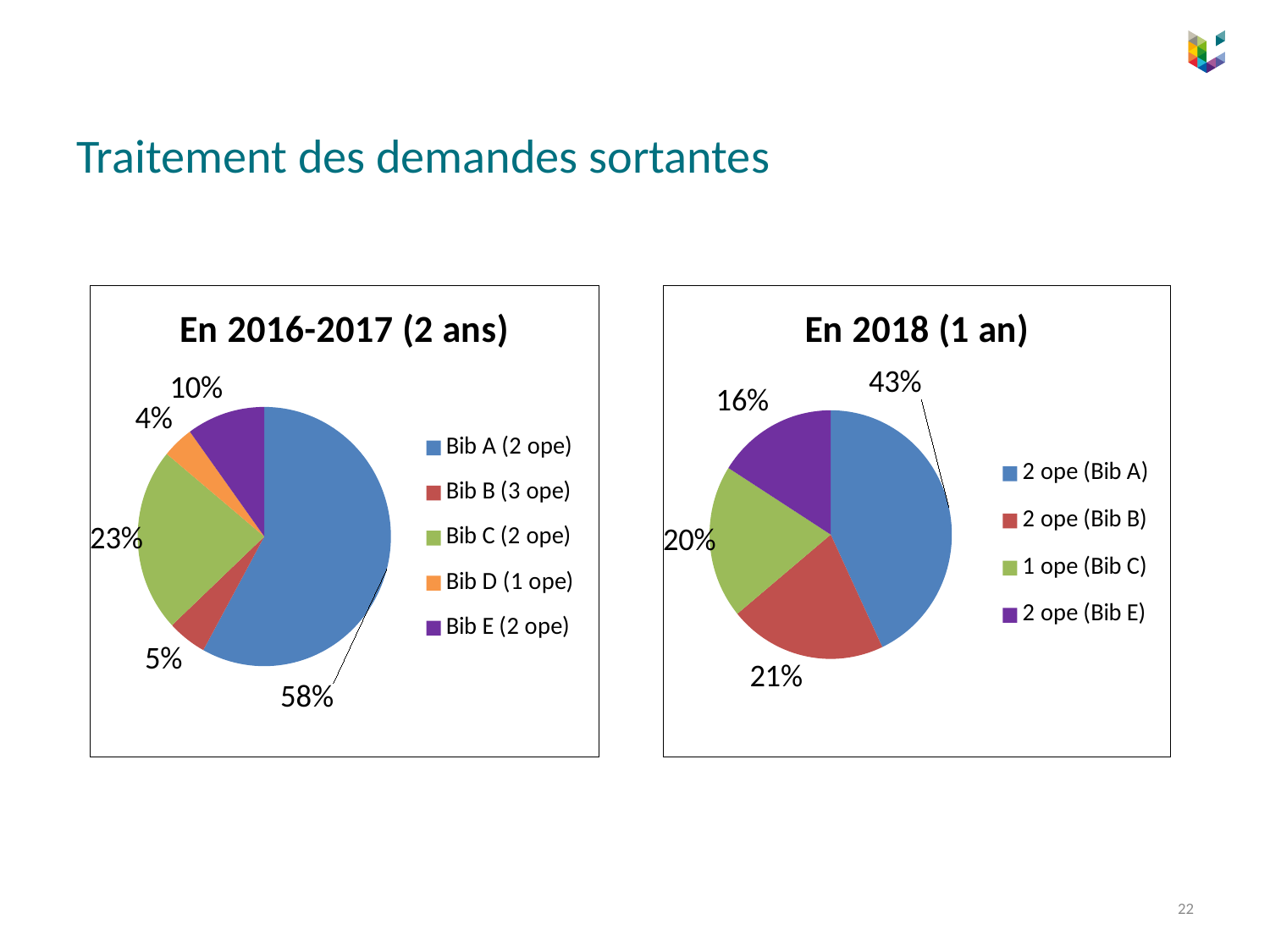
In the chart titled "En 2018 (1 an)", how many categories does the legend list? 4 In the chart titled "En 2016-2017 (2 ans)", how many categories does the legend list? 5 What kind of chart is the chart titled "En 2018 (1 an)"? Pie chart In the chart titled "En 2016-2017 (2 ans)", what is the difference between the shares of Bib E (2 ope) and Bib B (3 ope)? 5% In the chart titled "En 2018 (1 an)", which category has the largest slice? 2 ope (Bib A) In the chart titled "En 2018 (1 an)", what share does 2 ope (Bib A) have? 43% In the chart titled "En 2016-2017 (2 ans)", what share does Bib A (2 ope) have? 58% In the chart titled "En 2018 (1 an)", which is larger: the share of 2 ope (Bib B) or the share of 2 ope (Bib E)? 2 ope (Bib B) In the chart titled "En 2016-2017 (2 ans)", what share does Bib D (1 ope) have? 4% In the chart titled "En 2016-2017 (2 ans)", which category has the smallest slice? Bib D (1 ope)